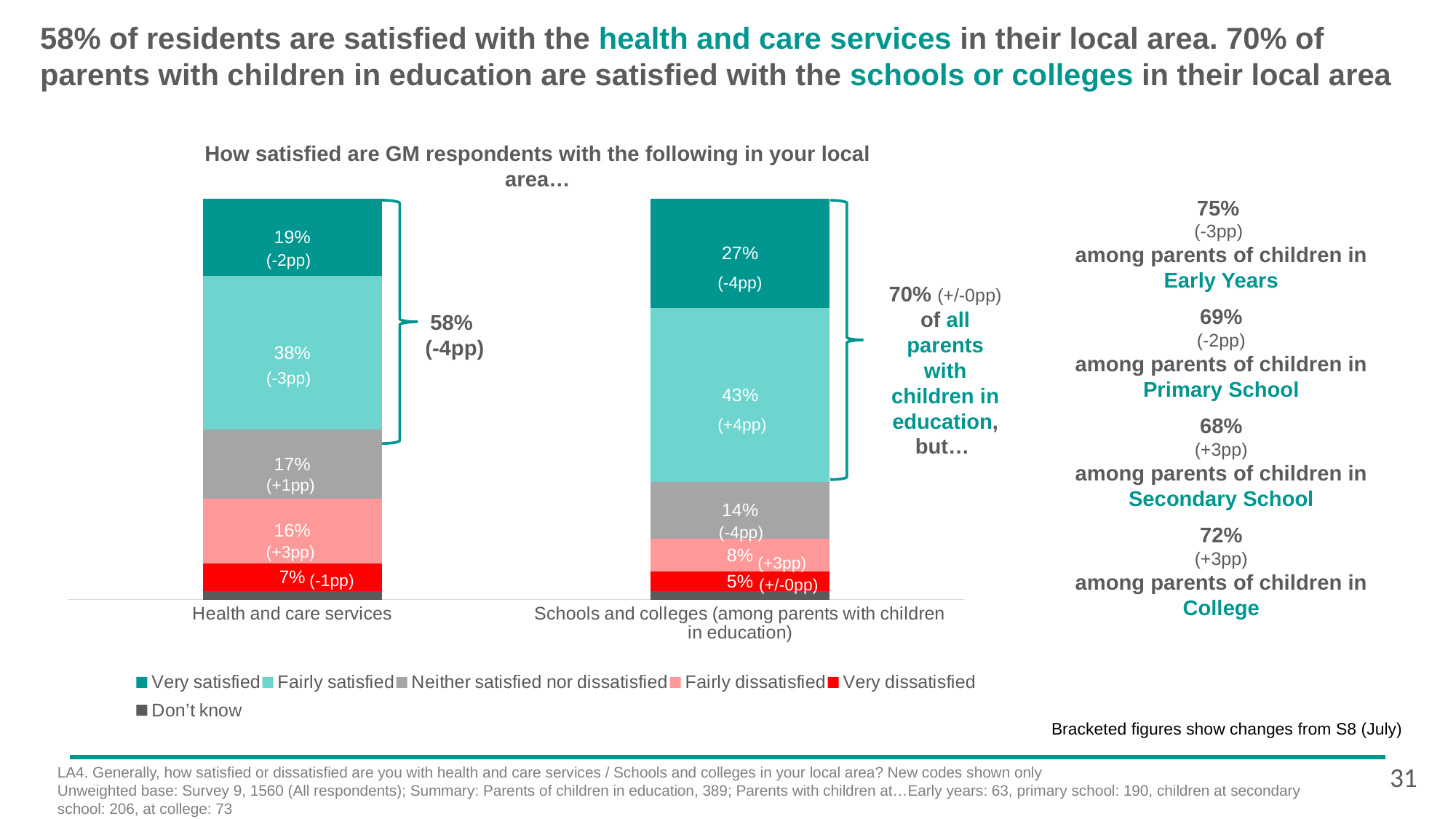
What is the difference between the fairly satisfied share for schools and colleges and the fairly satisfied share for health and care services? 5 percentage points Which category has the larger very satisfied share, health and care services or schools and colleges? Schools and colleges What kind of chart is shown on the slide? Stacked bar chart What percentage of parents with children in education are very dissatisfied with schools and colleges? 5% What is the combined share of very satisfied and fairly satisfied respondents for health and care services, as shown by the bracket label? 58% How many series does the chart legend list? 6 What is the title of the chart? How satisfied are GM respondents with the following in your local area… How many categories are shown on the x axis of the chart? 2 Which category has the larger fairly dissatisfied share, health and care services or schools and colleges? Health and care services What percentage of respondents are very satisfied with health and care services? 19% What percentage of respondents are neither satisfied nor dissatisfied with health and care services? 17% What percentage of parents with children in education are fairly satisfied with schools and colleges? 43%